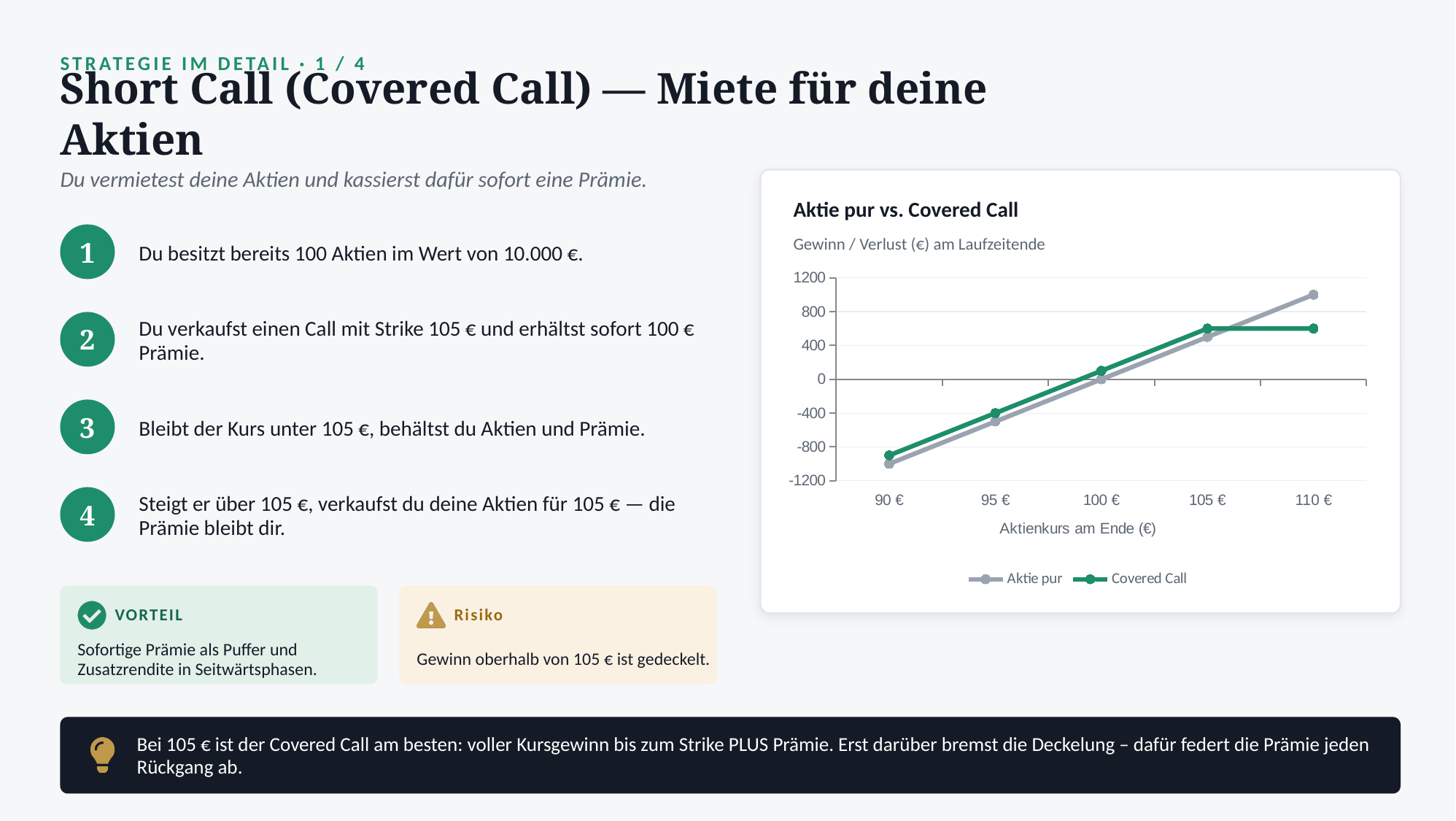
What is the title of the chart? Aktie pur vs. Covered Call What type of chart is shown on the slide? Line chart How many series does the chart legend list? 2 At a stock price of 95 €, which series has the higher value, Aktie pur or Covered Call? Covered Call At a stock price of 110 €, which series has the higher value, Aktie pur or Covered Call? Aktie pur What is the value of the Covered Call series at a stock price of 95 €? -400 How many stock price points are shown on the x axis of the chart? 5 Is the value of Aktie pur at 90 € greater or less than -800? less Is the value of Aktie pur at 110 € greater or less than 800? greater Does the Aktie pur series rise or fall as the stock price increases from 90 € to 110 €? Rises What is the value of the Aktie pur series at a stock price of 100 €? 0 Is the value of Covered Call at 110 € greater or less than 800? less